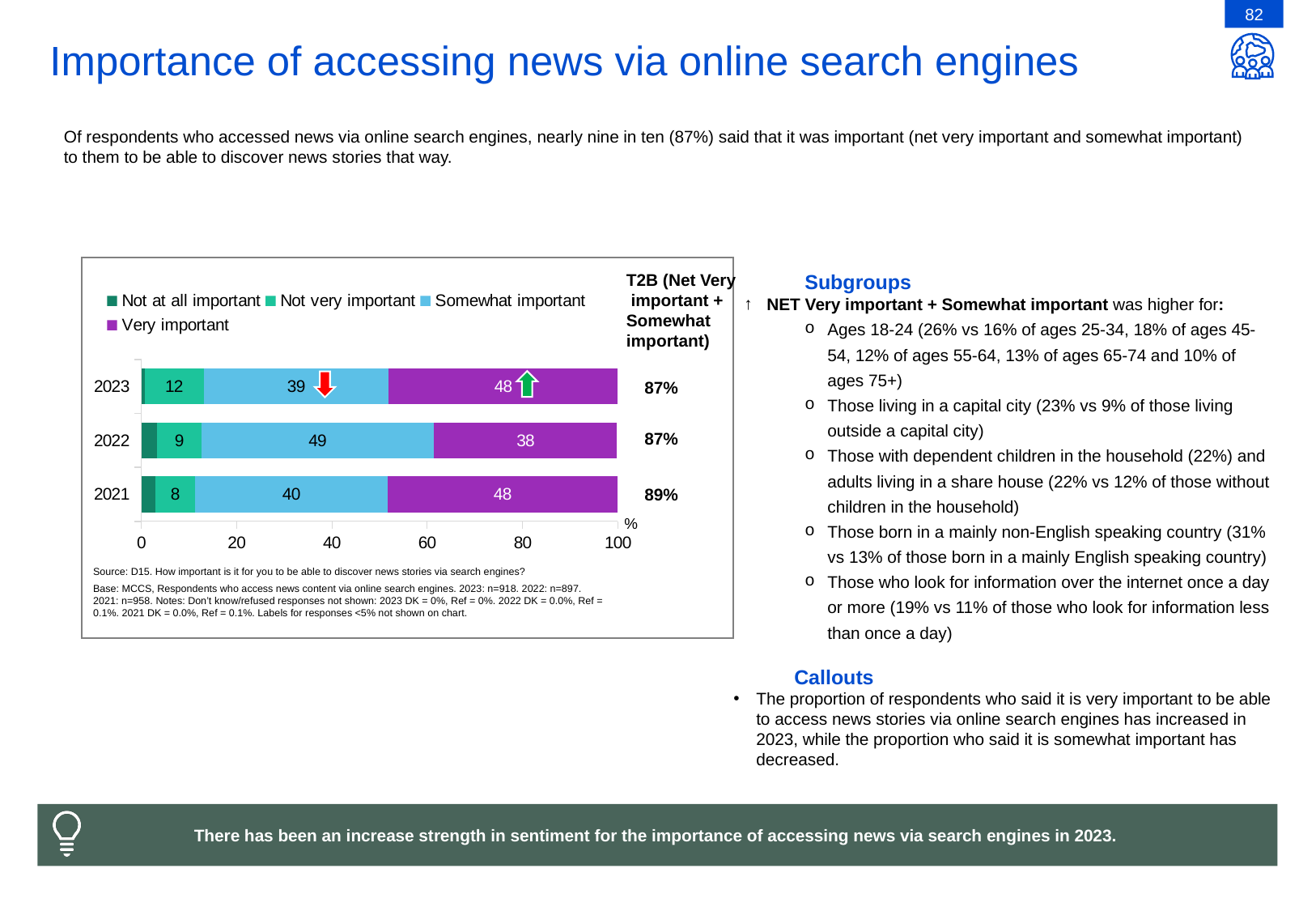
In which year was the 'Somewhat important' value highest? 2022 Which year had the larger 'Very important' value, 2022 or 2023? 2023 What percentage of respondents said accessing news via online search engines was very important in 2023? 48 How many series does the chart legend list? 4 What is the T2B (Net Very important + Somewhat important) figure shown for 2021? 89% In which year was the 'Very important' value lowest? 2022 How many years are shown on the chart? 3 What is the value for 'Somewhat important' in 2022? 49 By how many percentage points did the 'Somewhat important' value fall from 2022 to 2023? 10 What is the value for 'Not very important' in 2021? 8 Does the 'Not very important' value rise or fall from 2021 to 2023? Rise What kind of chart is used to show the importance ratings? Stacked bar chart